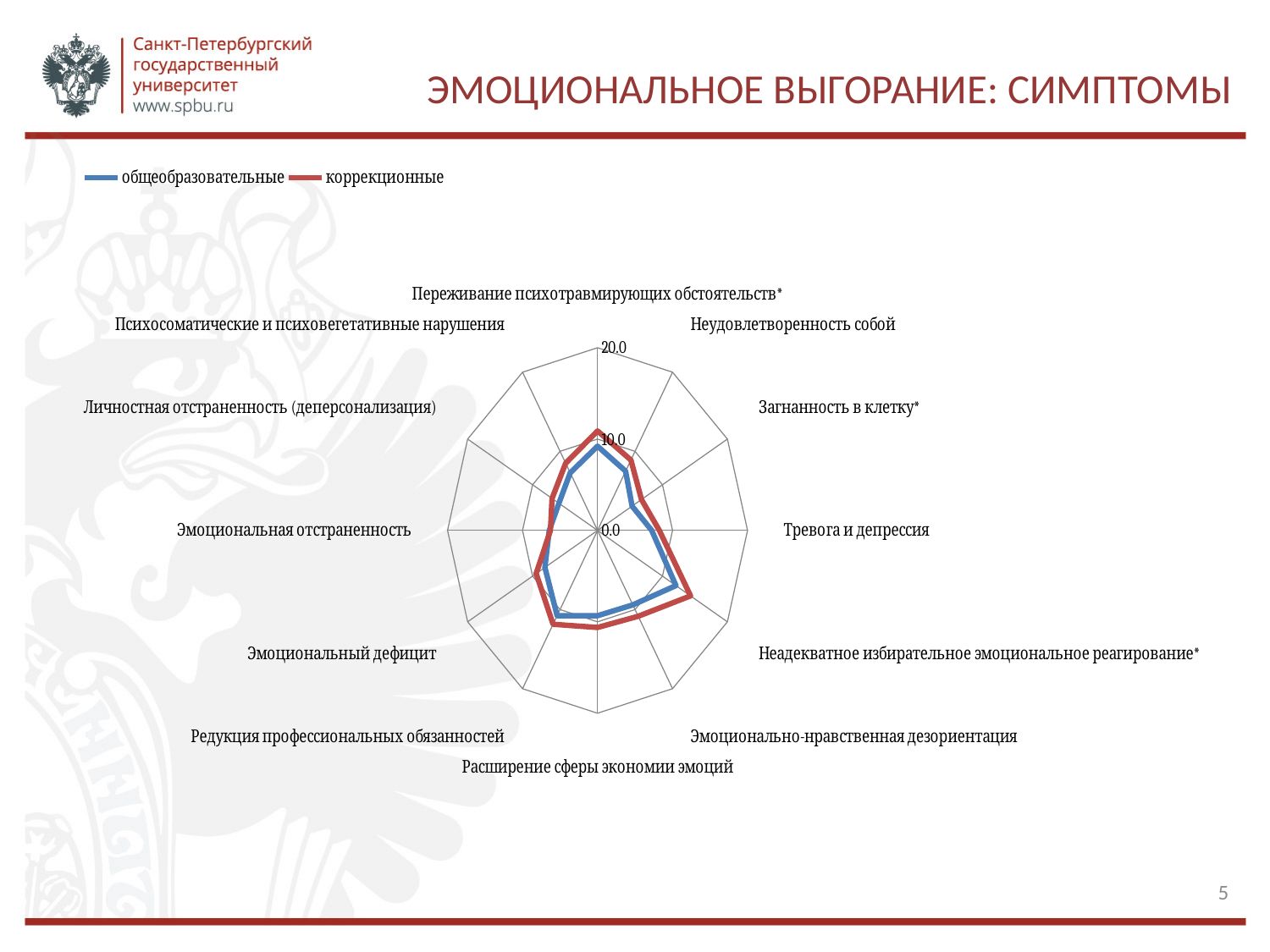
What kind of chart is shown on the slide? radar chart On Неадекватное избирательное эмоциональное реагирование*, which series has the larger value, общеобразовательные or коррекционные? коррекционные How many categories (symptoms) are plotted on the radar chart? 12 Is the value for коррекционные on Неадекватное избирательное эмоциональное реагирование* greater or less than 10.0? greater Which series is drawn in red? коррекционные How many series does the legend list? 2 For the коррекционные series, which category has the highest value? Неадекватное избирательное эмоциональное реагирование* Is the value for общеобразовательные on Тревога и депрессия greater or less than 10.0? less Is the value for коррекционные on Загнанность в клетку* greater or less than 10.0? less Which series is drawn in blue? общеобразовательные